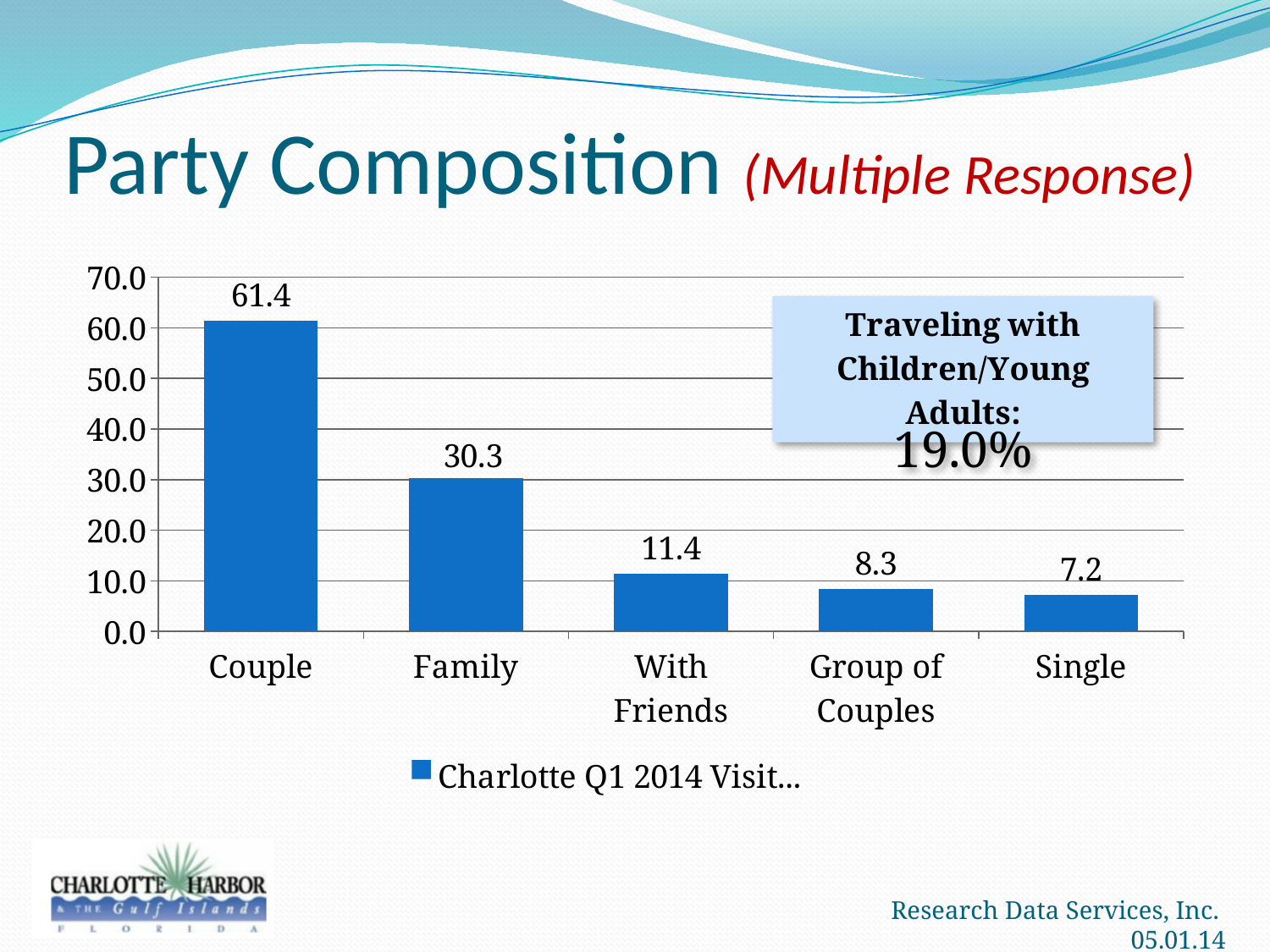
Which is larger, the value for Group of Couples or the value for Single? Group of Couples What is the difference between the values for Couple and Family? 31.1 What is the value for With Friends? 11.4 What percentage is given in the text box for traveling with children/young adults? 19.0% Which category has the highest value? Couple What is the value for Family? 30.3 Which category has the lowest value? Single What is the value for Single? 7.2 What is the value for Couple? 61.4 What kind of chart is shown on the slide? bar chart Is the value for Family greater or less than 40.0? less How many categories are shown on the x axis? 5